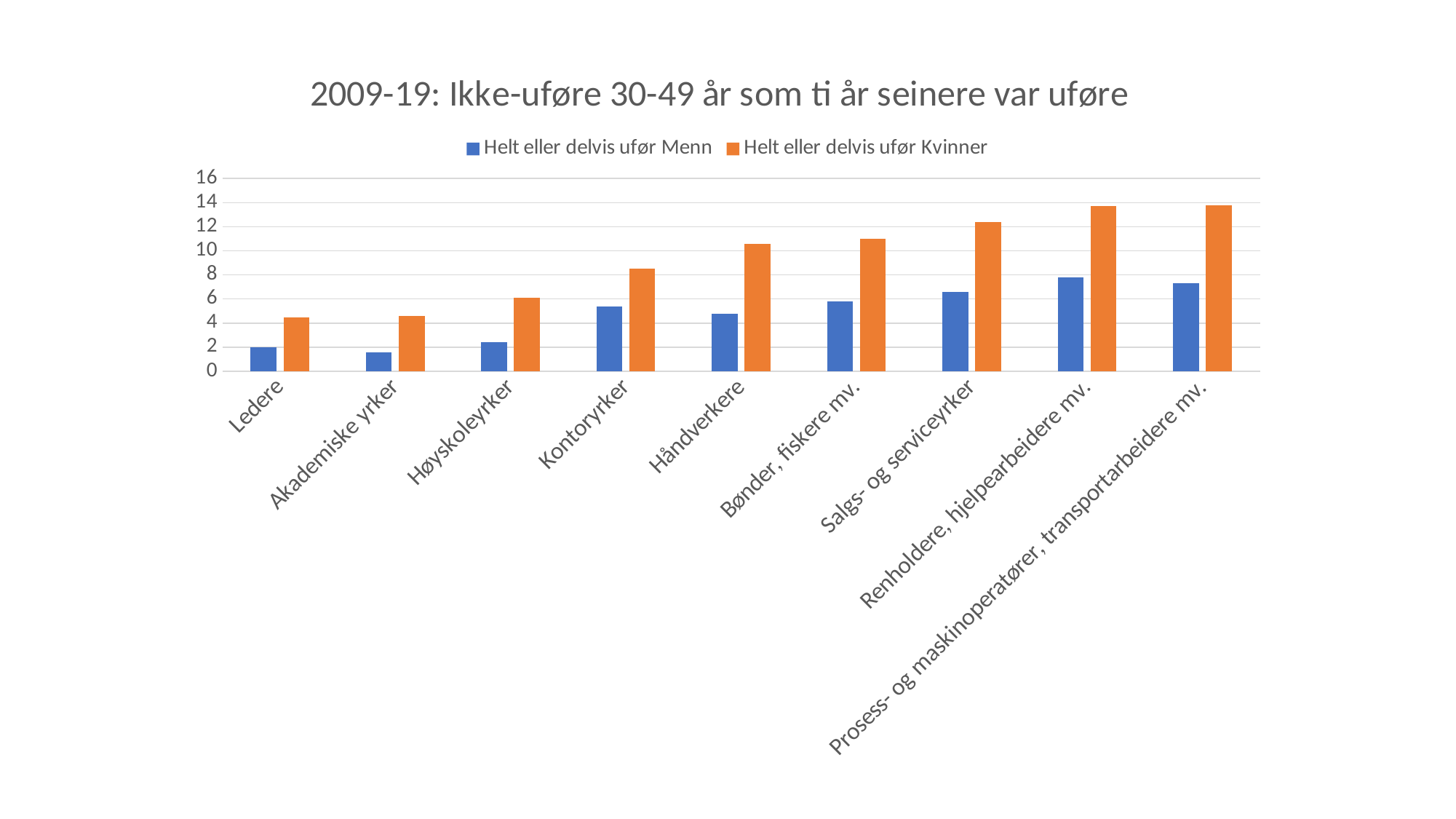
What kind of chart is shown on the slide? bar chart How many series does the legend list? 2 For Håndverkere, which is larger: Helt eller delvis ufør Menn or Helt eller delvis ufør Kvinner? Helt eller delvis ufør Kvinner How many occupational categories are shown on the x axis? 9 Is the value for Helt eller delvis ufør Kvinner in Kontoryrker greater or less than 8? greater Is the value for Helt eller delvis ufør Kvinner in Håndverkere greater or less than 10? greater Do the values for Helt eller delvis ufør Kvinner generally rise or fall from left to right along the x axis? rise Which series is shown in orange? Helt eller delvis ufør Kvinner Is the value for Helt eller delvis ufør Menn in Salgs- og serviceyrker greater or less than 6? greater What is the title of the chart? 2009-19: Ikke-uføre 30-49 år som ti år seinere var uføre